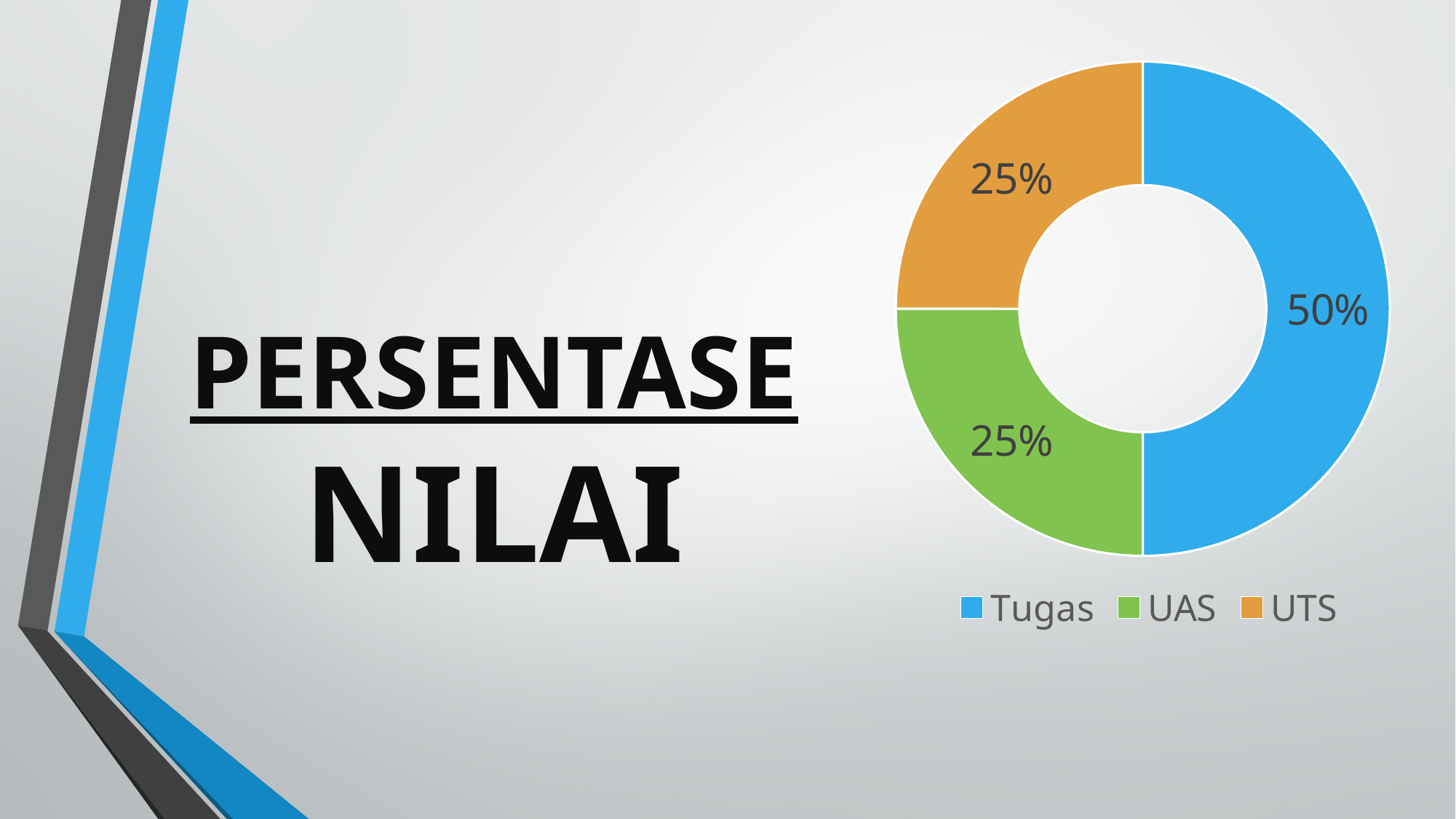
What share of the doughnut chart does Tugas represent? 50% Which is larger, the share for Tugas or the share for UTS? Tugas What share of the doughnut chart does UAS represent? 25% Which category has the largest share in the chart? Tugas What kind of chart is shown on the slide? Doughnut chart Which colour represents UAS in the chart? Green How many categories does the chart show? 3 Do UAS and UTS have the same share in the chart? Yes What is the title text shown on the slide next to the chart? PERSENTASE NILAI What share of the doughnut chart does UTS represent? 25% What is the difference between the share for Tugas and the share for UAS? 25%